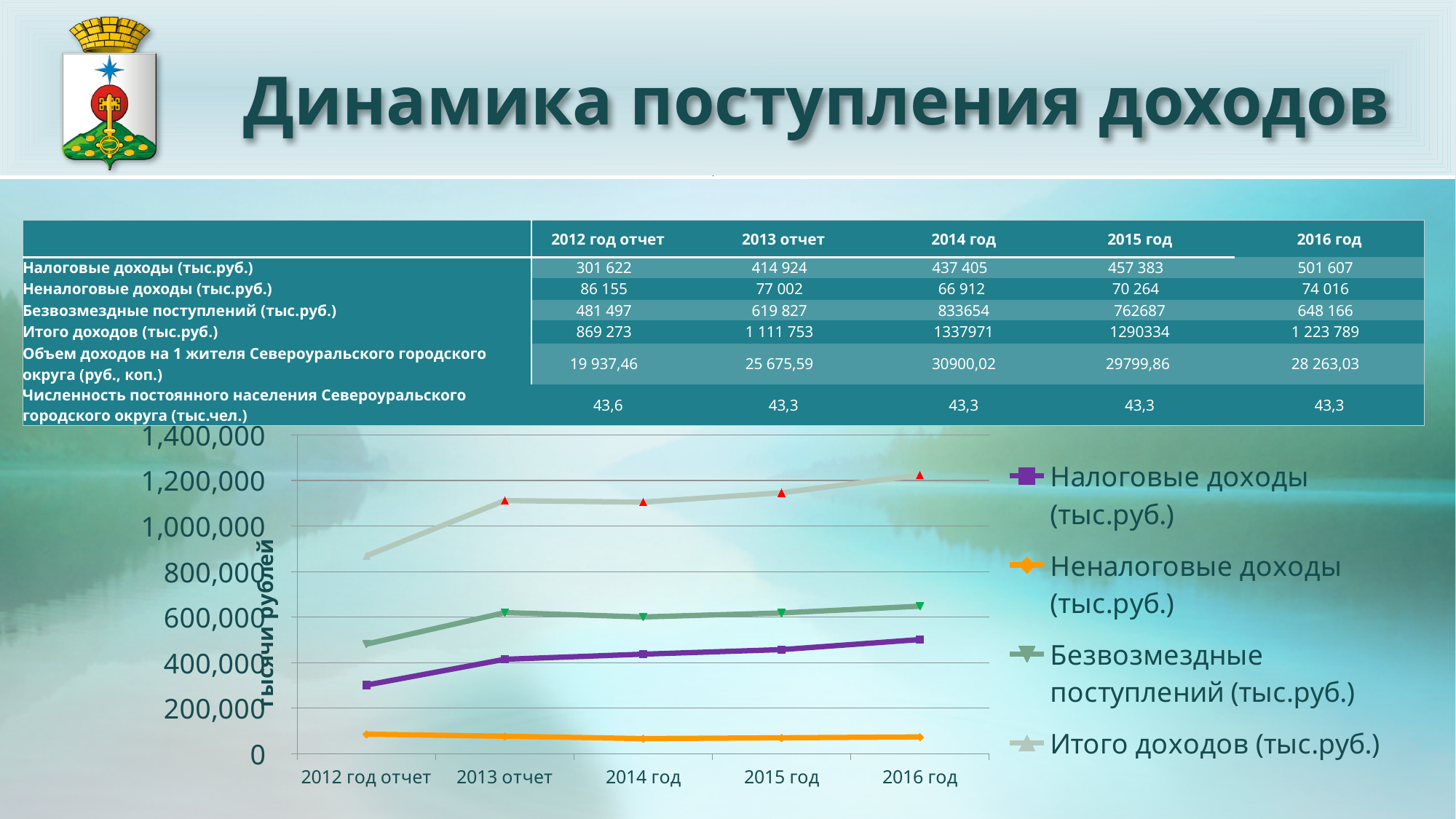
In which period is the Итого доходов (тыс.руб.) line at its lowest? 2012 год отчет How many series does the chart legend list? 4 Is the Неналоговые доходы (тыс.руб.) value for 2014 год greater or less than 200,000? less How many periods are plotted along the x axis of the chart? 5 In 2016 год, which is larger: Безвозмездные поступлений (тыс.руб.) or Налоговые доходы (тыс.руб.)? Безвозмездные поступлений (тыс.руб.) Is the Итого доходов (тыс.руб.) value for 2012 год отчет greater or less than 1,000,000? less Does the Налоговые доходы (тыс.руб.) line rise or fall from 2012 год отчет to 2016 год? rises In which period does the Итого доходов (тыс.руб.) line reach its highest point? 2016 год Is the Итого доходов (тыс.руб.) value for 2013 отчет greater or less than 1,000,000? greater What kind of chart is shown on the slide? line chart What is the Налоговые доходы (тыс.руб.) value for 2016 год, as printed in the table above the chart? 501 607 What is the title of the chart's vertical axis? тысячи рублей